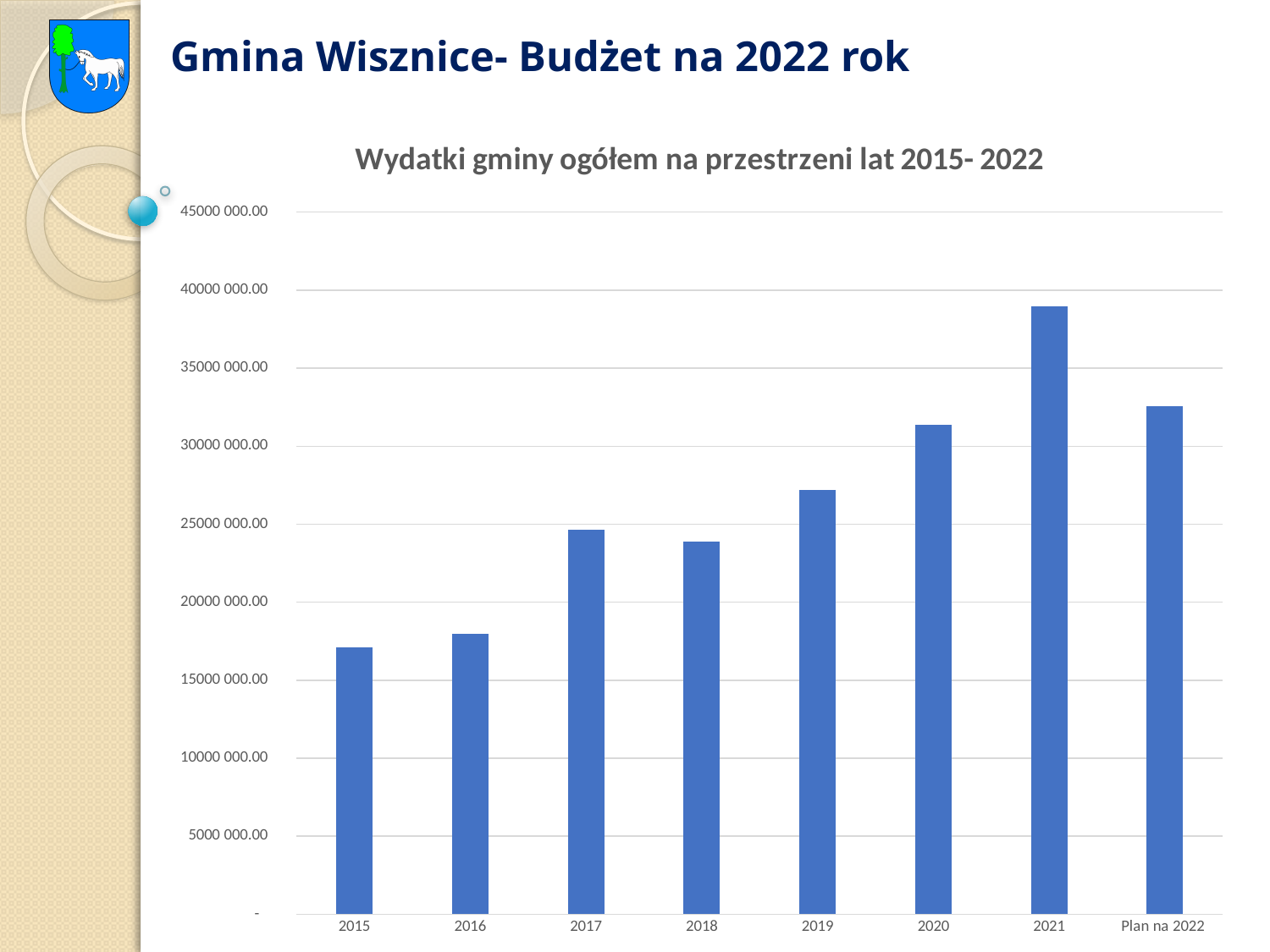
What type of chart is shown on the slide? bar chart What is the title of the chart? Wydatki gminy ogółem na przestrzeni lat 2015- 2022 Which category has the highest value? 2021 Is the value for 2020 greater or less than 30000 000.00? greater Is the value for 2018 greater or less than 25000 000.00? less Is the value for 2021 greater or less than 40000 000.00? less Which is larger, the value for 2021 or the value for Plan na 2022? 2021 Which category has the lowest value? 2015 Which is larger, the value for 2016 or the value for 2019? 2019 How many bars (categories) are plotted in the chart? 8